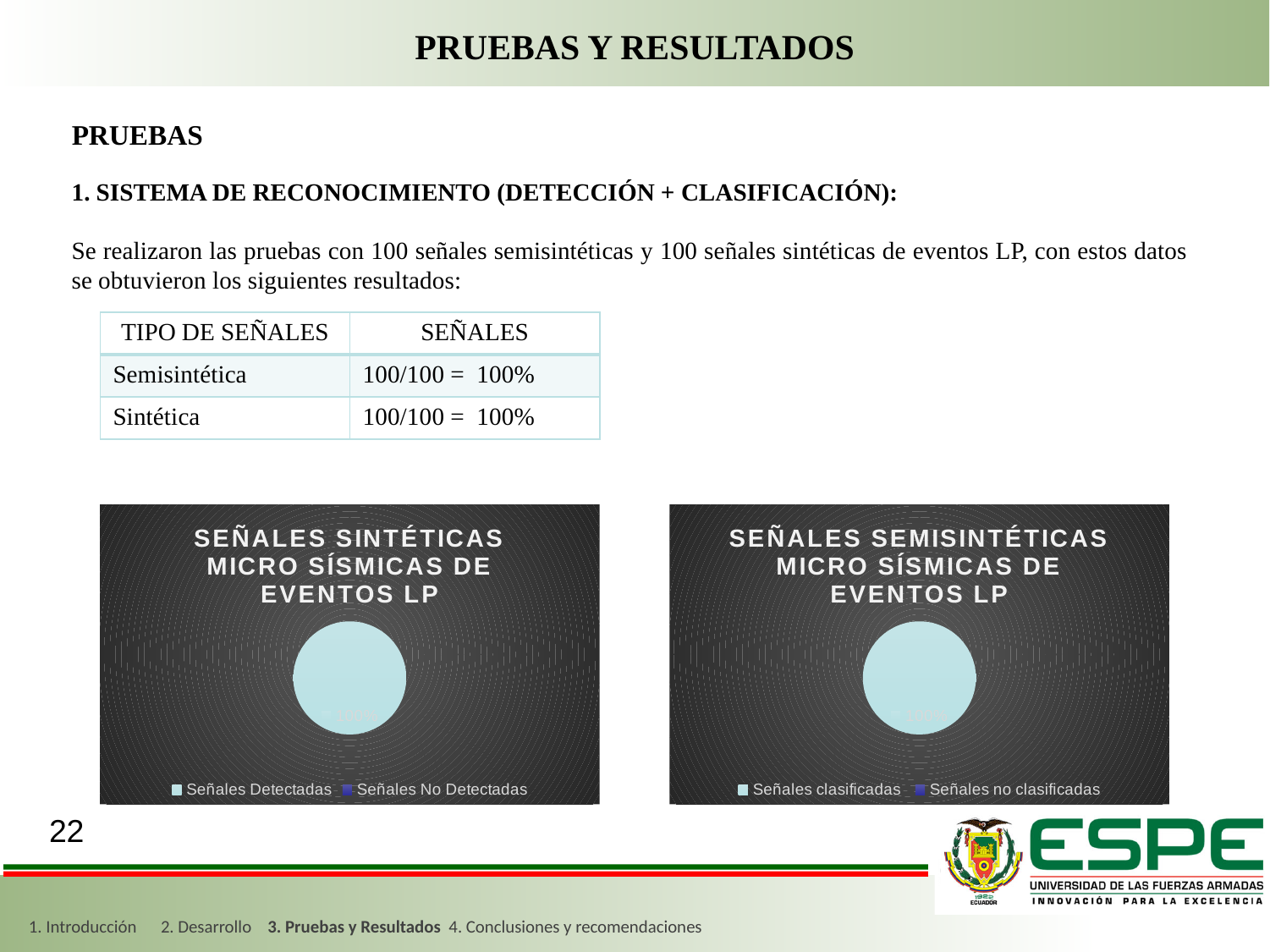
In the right chart (Señales Semisintéticas), how many entries does the legend list? 2 In the right chart (Señales Semisintéticas), which is larger: the share of 'Señales clasificadas' or 'Señales no clasificadas'? Señales clasificadas What are the two legend entries of the left chart (Señales Sintéticas)? Señales Detectadas, Señales No Detectadas In the left chart (Señales Sintéticas), which legend category makes up the largest share of the pie? Señales Detectadas In the left chart (Señales Sintéticas), what share of the pie is 'Señales Detectadas'? 100% In the right chart (Señales Semisintéticas), which legend category makes up the largest share of the pie? Señales clasificadas In the left chart (Señales Sintéticas), which is larger: the share of 'Señales Detectadas' or 'Señales No Detectadas'? Señales Detectadas What kind of chart is the right chart titled 'SEÑALES SEMISINTÉTICAS MICRO SÍSMICAS DE EVENTOS LP'? Pie chart In the right chart (Señales Semisintéticas), what share of the pie is 'Señales clasificadas'? 100% What is the title of the right chart? SEÑALES SEMISINTÉTICAS MICRO SÍSMICAS DE EVENTOS LP What kind of chart is the left chart titled 'SEÑALES SINTÉTICAS MICRO SÍSMICAS DE EVENTOS LP'? Pie chart In the left chart (Señales Sintéticas), how many entries does the legend list? 2